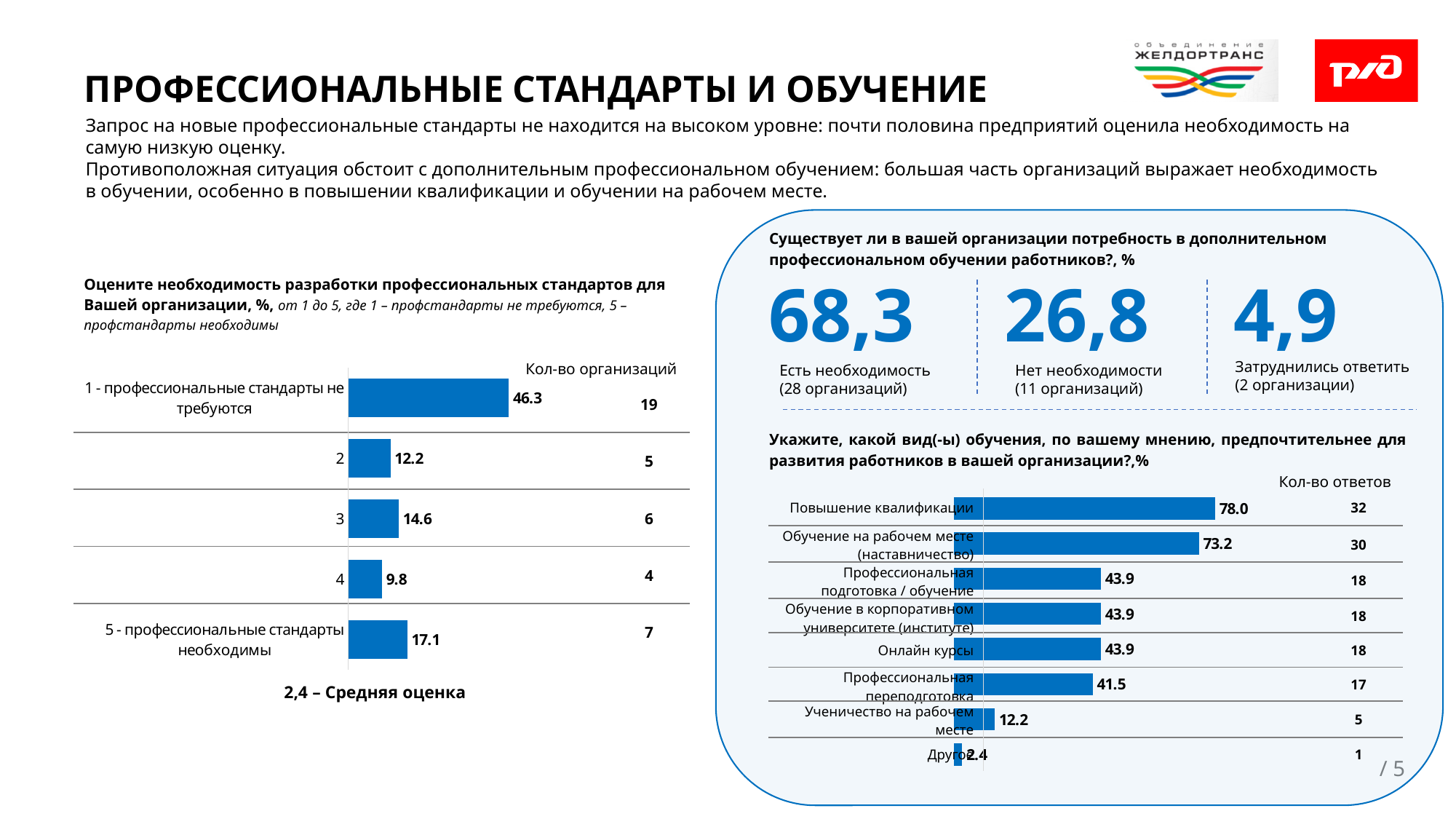
In the right chart (Укажите, какой вид(-ы) обучения), which category has the highest value? Повышение квалификации In the left chart (Оцените необходимость разработки профессиональных стандартов), what is the value for category '1 - профессиональные стандарты не требуются'? 46.3 In the right chart (Укажите, какой вид(-ы) обучения), what is the value for 'Ученичество на рабочем месте'? 12.2 In the left chart (Оцените необходимость разработки профессиональных стандартов), what is the value for category '5 - профессиональные стандарты необходимы'? 17.1 In the left chart (Оцените необходимость разработки профессиональных стандартов), which category has the lowest value? 4 In the left chart (Оцените необходимость разработки профессиональных стандартов), what is the difference between the values for category 1 and category 5? 29.2 In the left chart (Оцените необходимость разработки профессиональных стандартов), how many categories are plotted? 5 In the right chart (Укажите, какой вид(-ы) обучения), how many categories are plotted? 8 What type of chart is the right chart (Укажите, какой вид(-ы) обучения)? Bar chart In the right chart (Укажите, какой вид(-ы) обучения), what is the value for 'Повышение квалификации'? 78.0 In the right chart (Укажите, какой вид(-ы) обучения), what is the difference between 'Повышение квалификации' and 'Обучение на рабочем месте (наставничество)'? 4.8 In the left chart (Оцените необходимость разработки профессиональных стандартов), which is larger: the value for category 2 or category 3? 3